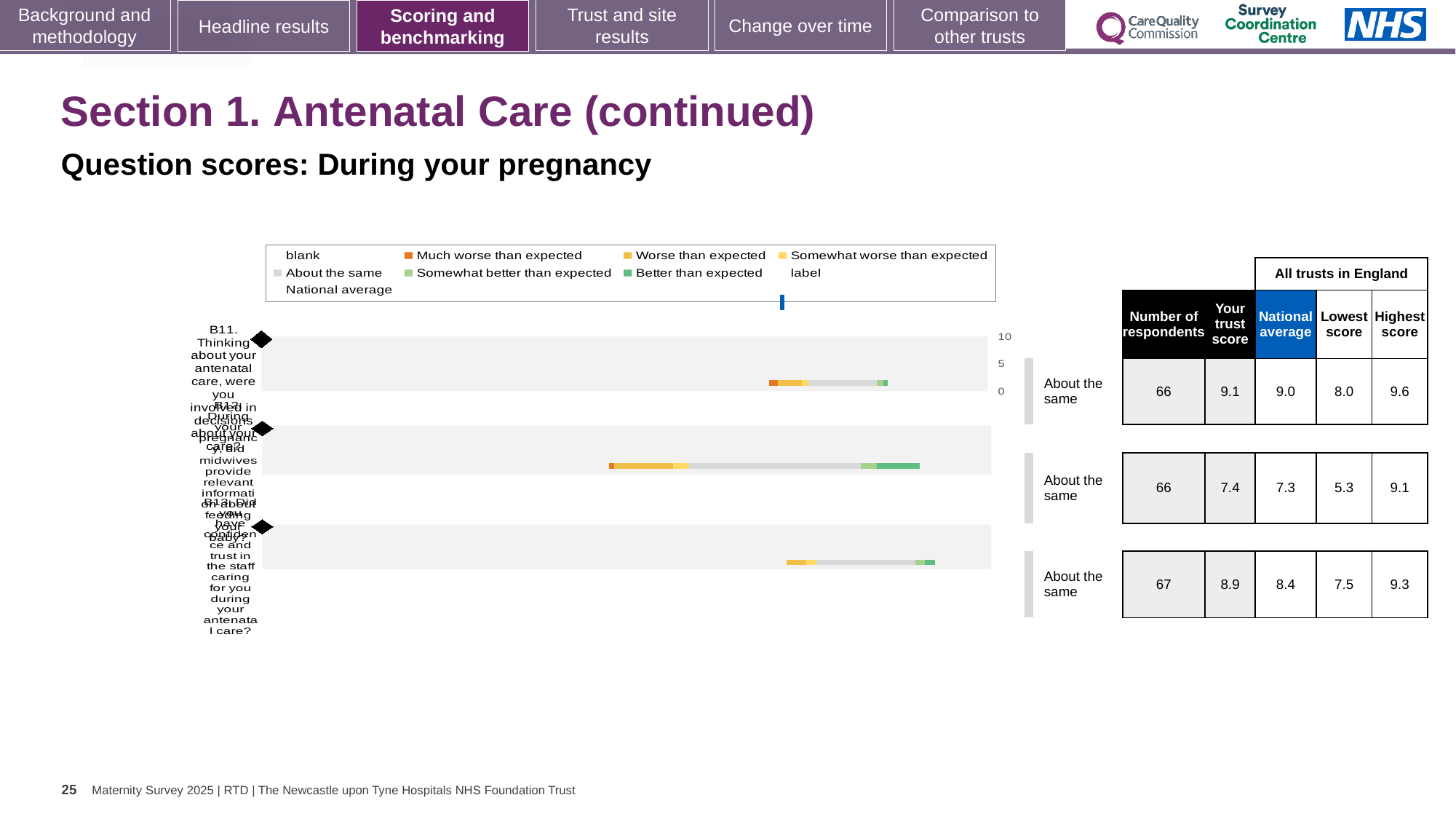
How many questions (bars) are plotted in the chart? 3 What is the number of respondents for question B13? 67 Is the trust score for question B12 larger or smaller than the national average for B12? larger Which question has the lowest 'Your trust score' in the table? B12 What is the 'Your trust score' for question B11 shown in the table next to the chart? 9.1 What benchmark category is shown for question B11? About the same What is the difference between the trust score and the national average for question B13? 0.5 What is the highest score among all trusts in England for question B13? 9.3 What does the legend entry with the dark green colour represent? Better than expected What kind of chart is shown on the slide? bar chart Which question has the highest 'Lowest score' across all trusts in England? B11 What is the national average for question B12 shown in the table next to the chart? 7.3